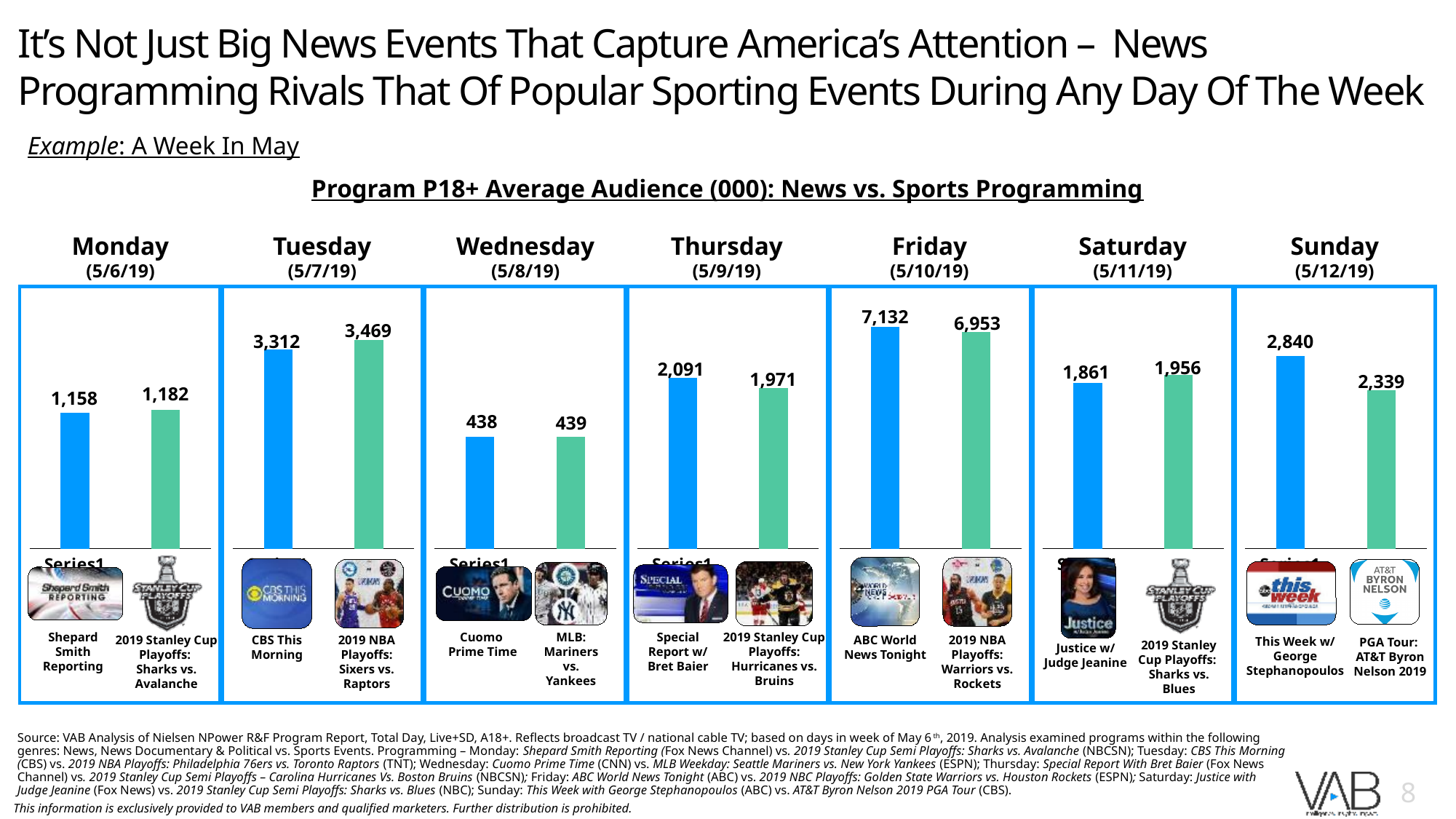
What type of chart is used for the Monday (5/6/19) data? Bar chart In the Thursday (5/9/19) chart, what is the difference between Special Report w/ Bret Baier and 2019 Stanley Cup Playoffs: Hurricanes vs. Bruins? 120 In the Sunday (5/12/19) chart, which program has the higher value? This Week w/ George Stephanopoulos In the Monday (5/6/19) chart, what is the value for Shepard Smith Reporting? 1,158 In the Friday (5/10/19) chart, what is the value for ABC World News Tonight? 7,132 In the Tuesday (5/7/19) chart, what is the value for 2019 NBA Playoffs: Sixers vs. Raptors? 3,469 In the Friday (5/10/19) chart, which is larger: ABC World News Tonight or 2019 NBA Playoffs: Warriors vs. Rockets? ABC World News Tonight In the Wednesday (5/8/19) chart, what is the value for Cuomo Prime Time? 438 What is the title shown above the seven daily charts? Program P18+ Average Audience (000): News vs. Sports Programming How many bars are shown in the Tuesday (5/7/19) chart? 2 In the Sunday (5/12/19) chart, what is the value for PGA Tour: AT&T Byron Nelson 2019? 2,339 In the Saturday (5/11/19) chart, what is the difference between 2019 Stanley Cup Playoffs: Sharks vs. Blues and Justice w/ Judge Jeanine? 95